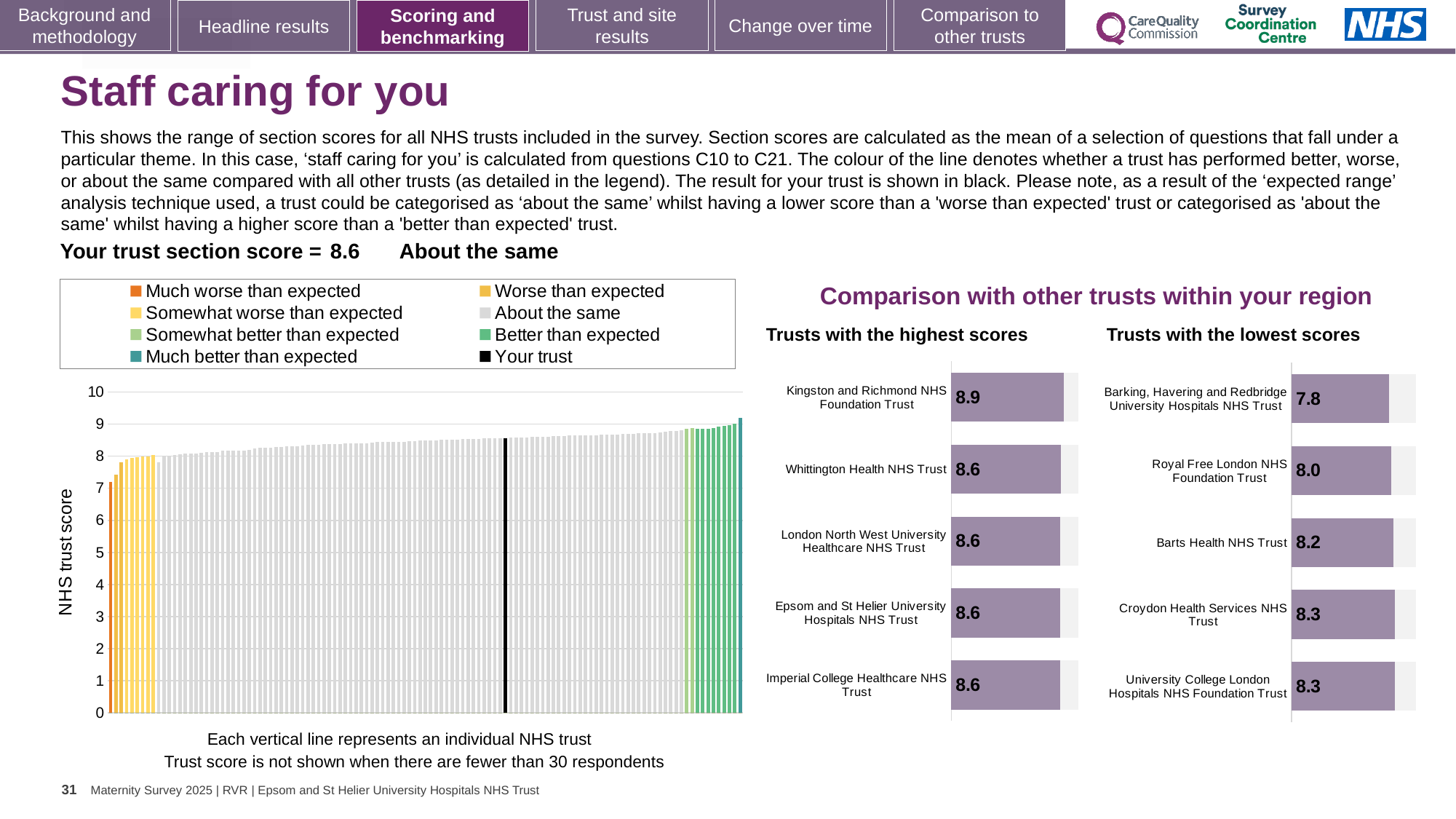
In the 'Trusts with the highest scores' chart, what is the score for Kingston and Richmond NHS Foundation Trust? 8.9 In the 'Trusts with the lowest scores' chart, what is the score for Barking, Havering and Redbridge University Hospitals NHS Trust? 7.8 In the 'Trusts with the lowest scores' chart, which has the higher score: Royal Free London NHS Foundation Trust or Croydon Health Services NHS Trust? Croydon Health Services NHS Trust In the 'Trusts with the lowest scores' chart, which trust has the lowest score? Barking, Havering and Redbridge University Hospitals NHS Trust In the 'Trusts with the highest scores' chart, which trust has the highest score? Kingston and Richmond NHS Foundation Trust In the 'Trusts with the lowest scores' chart, what is the difference between the scores of Barts Health NHS Trust and Barking, Havering and Redbridge University Hospitals NHS Trust? 0.4 How many trusts are shown in the 'Trusts with the highest scores' chart? 5 In the 'Trusts with the highest scores' chart, what is the difference between the scores of Kingston and Richmond NHS Foundation Trust and Whittington Health NHS Trust? 0.3 What kind of chart is the 'NHS trust score' chart on the left of the slide? bar chart How many trusts are shown in the 'Trusts with the lowest scores' chart? 5 In the 'NHS trust score' chart on the left, is the value of the black 'Your trust' bar greater or less than 8? greater How many entries does the legend of the 'NHS trust score' chart on the left list? 8